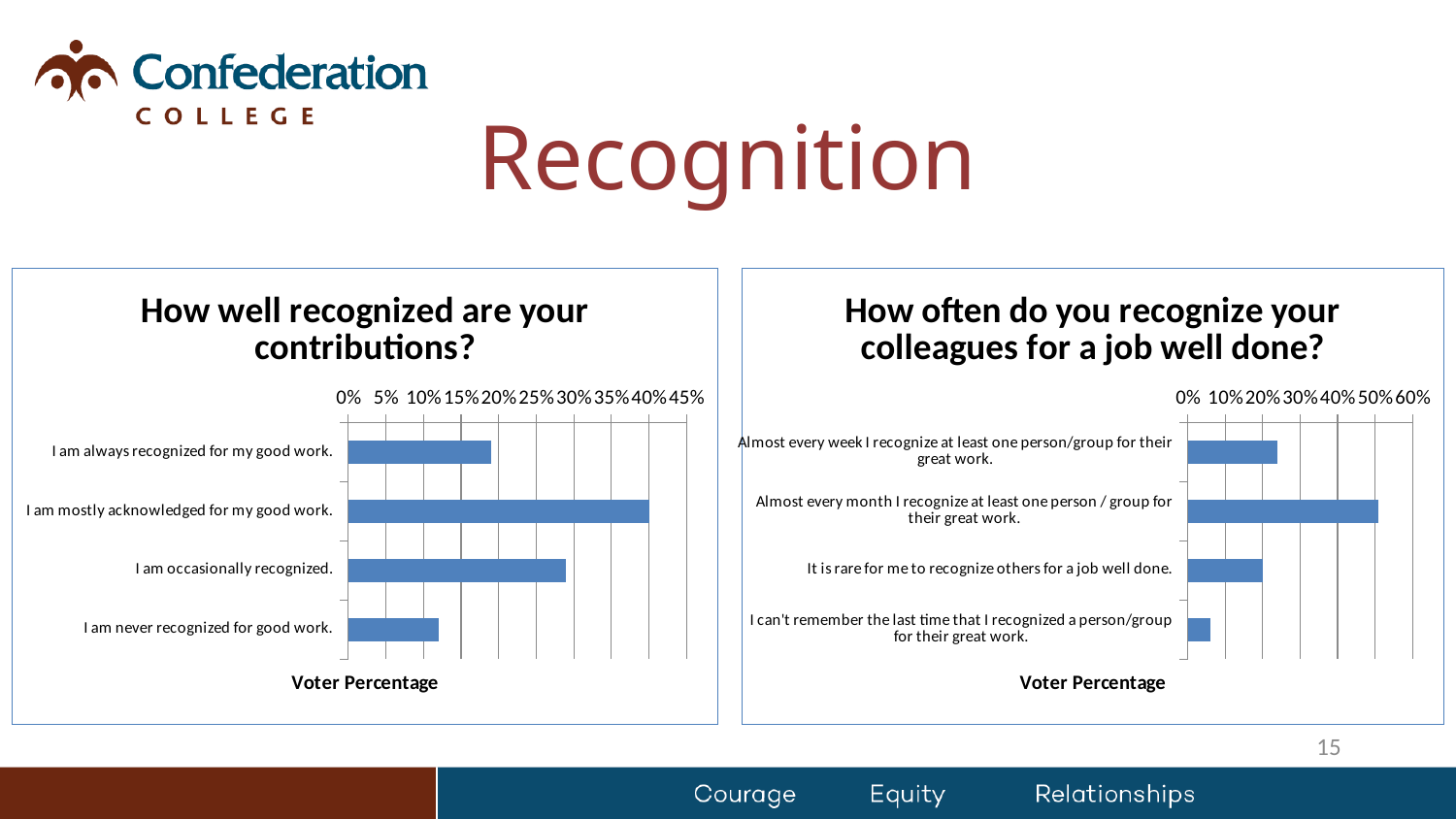
How many categories are shown in the right chart, 'How often do you recognize your colleagues for a job well done?'? 4 In the right chart, 'How often do you recognize your colleagues for a job well done?', which category has the highest value? Almost every month I recognize at least one person / group for their great work. What is the horizontal axis title of the right chart, 'How often do you recognize your colleagues for a job well done?'? Voter Percentage In the left chart, 'How well recognized are your contributions?', is the value for 'I am mostly acknowledged for my good work.' greater or less than 35%? greater In the left chart, 'How well recognized are your contributions?', which category has the highest value? I am mostly acknowledged for my good work. In the left chart, 'How well recognized are your contributions?', is the value for 'I am never recognized for good work.' greater or less than 15%? less In the left chart, 'How well recognized are your contributions?', which is larger: 'I am always recognized for my good work.' or 'I am occasionally recognized.'? I am occasionally recognized. In the left chart, 'How well recognized are your contributions?', which category has the lowest value? I am never recognized for good work. How many categories are shown in the left chart, 'How well recognized are your contributions?'? 4 In the right chart, 'How often do you recognize your colleagues for a job well done?', is the value for 'Almost every month I recognize at least one person / group for their great work.' greater or less than 40%? greater What kind of chart is the left chart, 'How well recognized are your contributions?'? bar chart In the right chart, 'How often do you recognize your colleagues for a job well done?', which category has the lowest value? I can't remember the last time that I recognized a person/group for their great work.